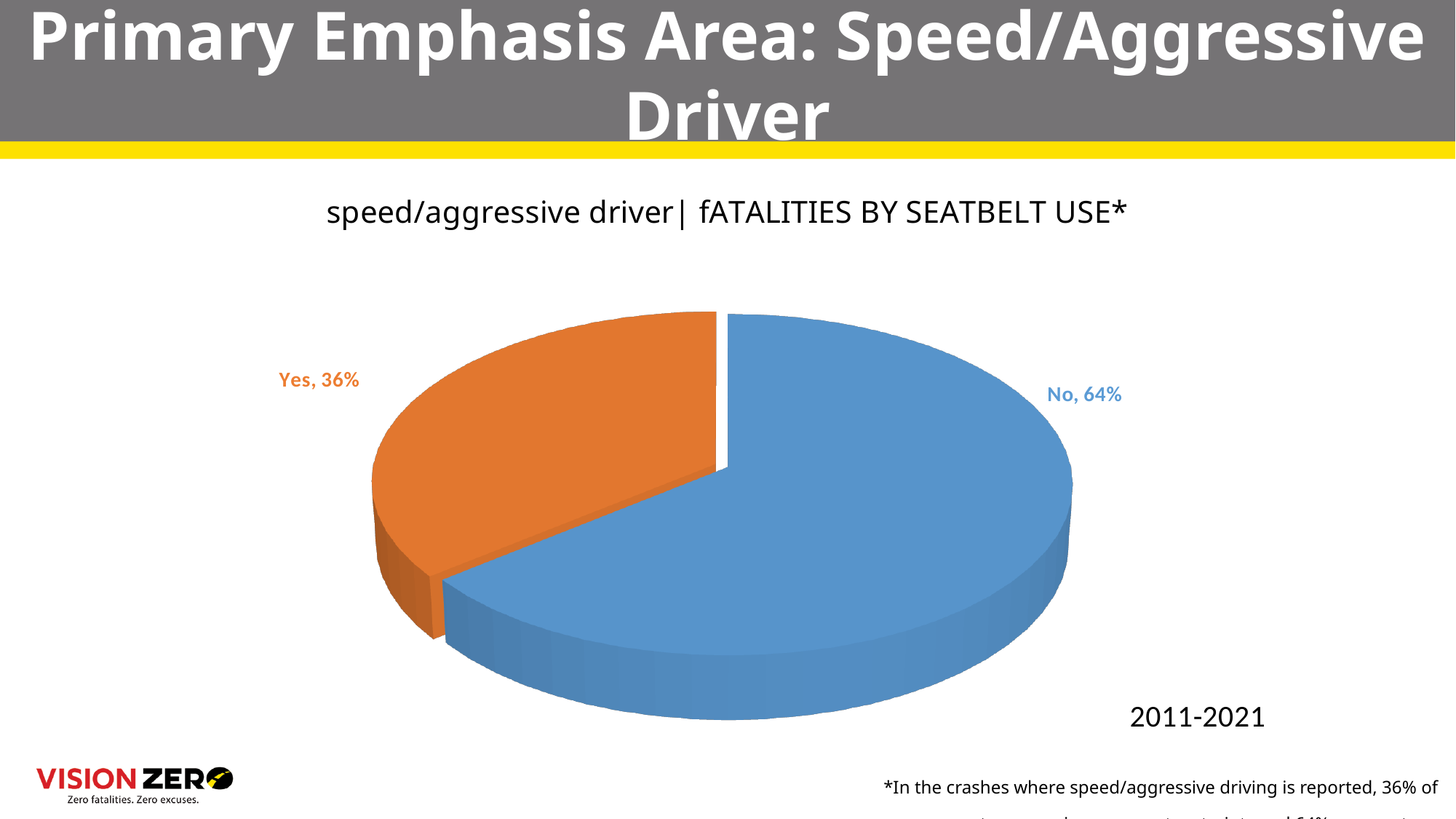
What time period is shown next to the chart? 2011-2021 Which category has the largest slice of the pie? No Which category has the smallest slice of the pie? Yes What kind of chart is shown on the slide? Pie chart What colour is the "Yes" slice of the pie? Orange What is the title of the chart? speed/aggressive driver| fATALITIES BY SEATBELT USE* What share of the pie does the "No" slice represent? 64% How many slices does the pie chart have? 2 Which slice is larger, "Yes" or "No"? No What is the difference in percentage points between the "No" and "Yes" slices? 28 What share of the pie does the "Yes" slice represent? 36%